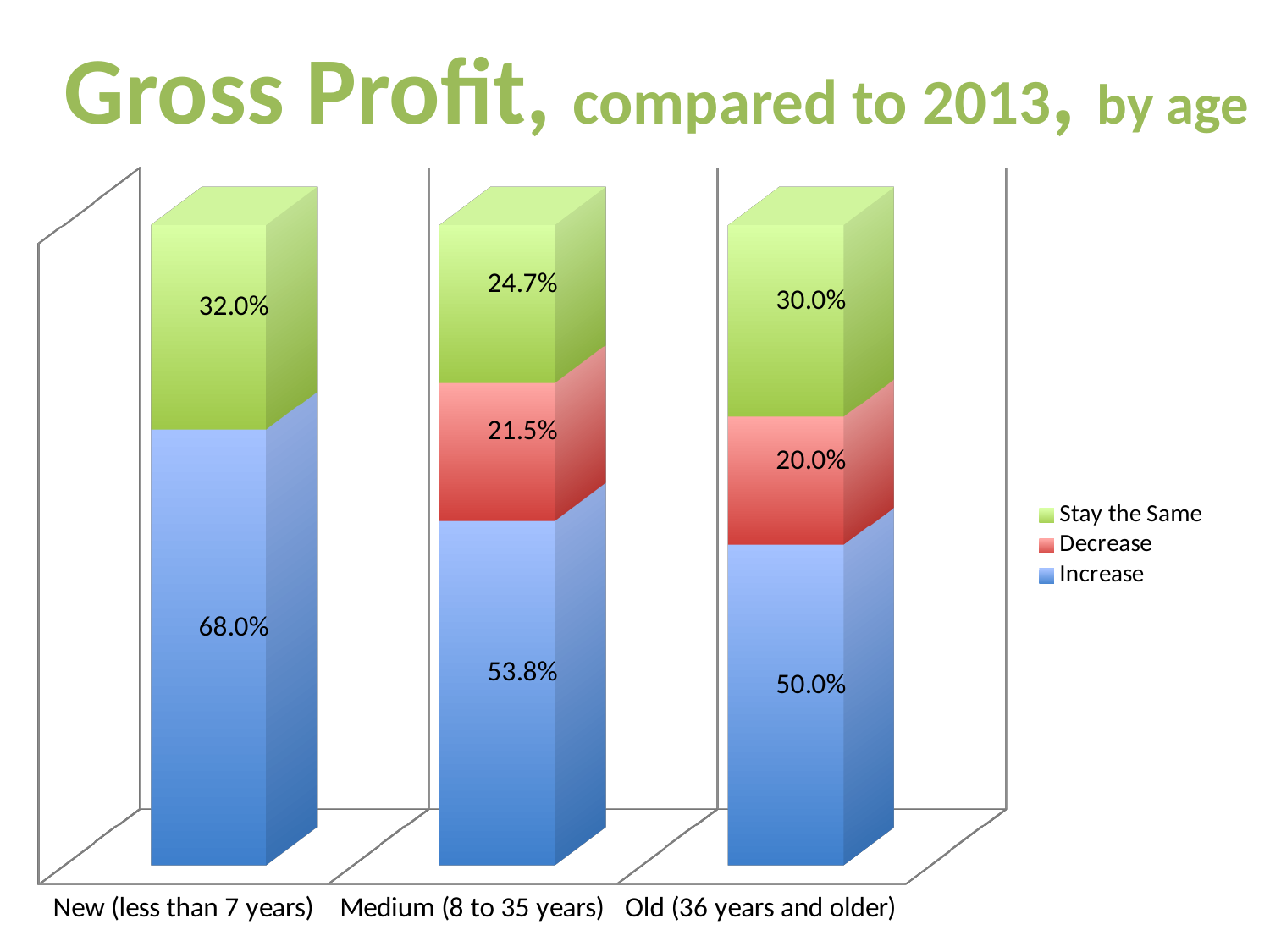
Which is larger for the Medium (8 to 35 years) group: the Stay the Same value or the Decrease value? Stay the Same What is the difference between the Increase values for the New (less than 7 years) and Old (36 years and older) groups? 18.0% What percentage of the New (less than 7 years) group reported an Increase in gross profit? 68.0% Which age group has the highest Increase value? New (less than 7 years) How many series does the legend list? 3 Which colour represents the Decrease series in the legend? Red Does the Increase value rise or fall moving from the New group to the Old group along the x axis? Fall What is the Stay the Same value for the Old (36 years and older) group? 30.0% What is the Decrease value for the Medium (8 to 35 years) group? 21.5% Which age group has the lowest Stay the Same value? Medium (8 to 35 years) How many age groups are shown on the x axis? 3 What kind of chart is shown on the slide? Stacked bar chart